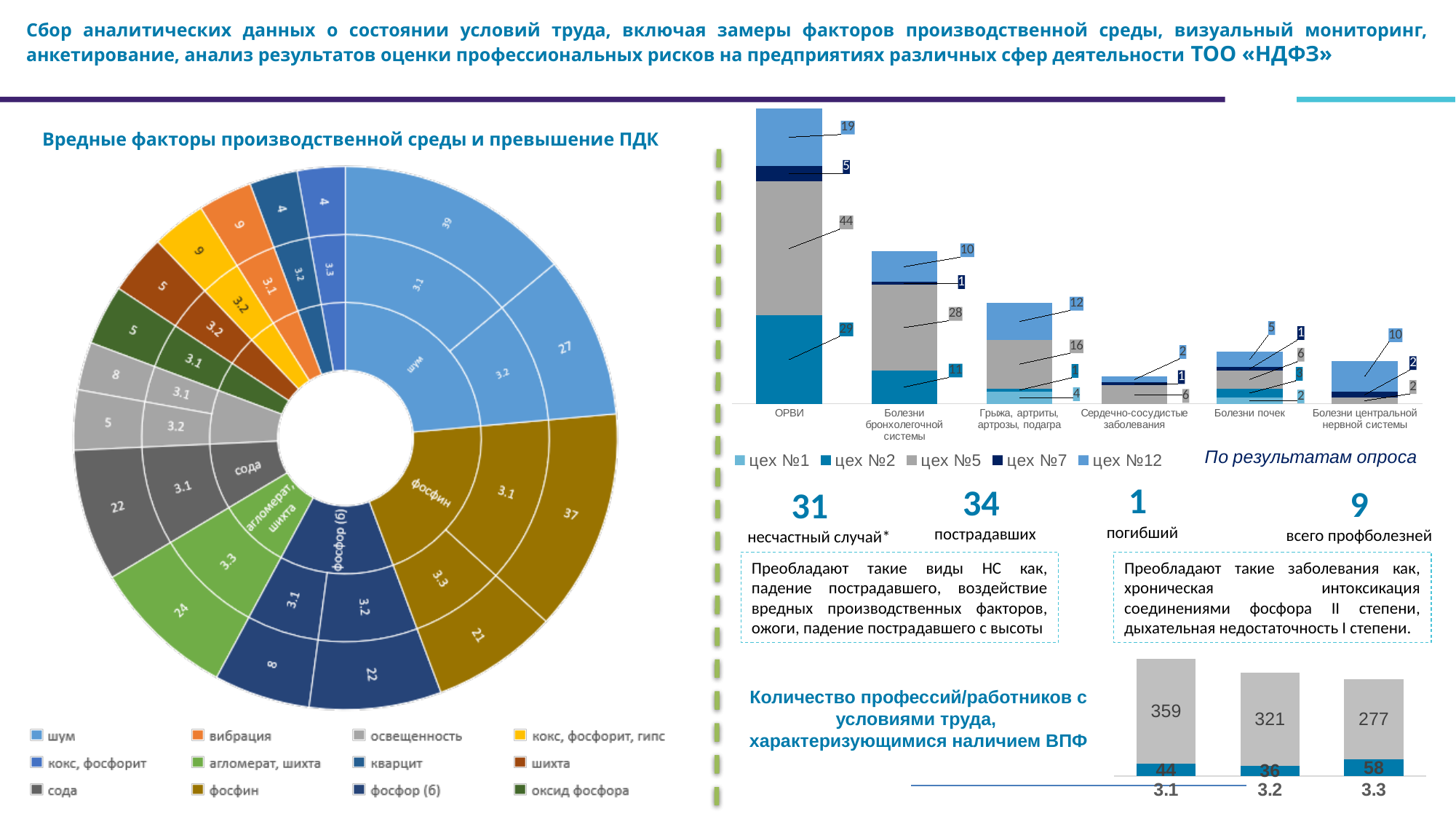
In the top-right chart of diseases by workshop, which disease category has the tallest stacked bar? ОРВИ In the top-right chart of diseases by workshop, what is the value for цех №5 in the ОРВИ category? 44 In the top-right chart of diseases by workshop, what is the total of the stacked bar for ОРВИ? 97 How many entries does the legend of the left chart 'Вредные факторы производственной среды и превышение ПДК' list? 12 In the top-right chart of diseases by workshop, what is the value for цех №2 in the Болезни бронхолегочной системы category? 11 In the bottom-right chart 'Количество профессий/работников с условиями труда, характеризующимися наличием ВПФ', what is the value of the grey segment for category 3.1? 359 In the top-right chart of diseases by workshop, how many disease categories are shown on the x axis? 6 What kind of chart is the top-right chart showing diseases by workshop (цех)? stacked bar chart In the bottom-right chart 'Количество профессий/работников с условиями труда, характеризующимися наличием ВПФ', do the grey segment values rise or fall from 3.1 to 3.3? fall In the top-right chart of diseases by workshop, how many series does the legend list? 5 In the bottom-right chart 'Количество профессий/работников с условиями труда, характеризующимися наличием ВПФ', what is the total of the stacked bar for category 3.3? 335 In the top-right chart of diseases by workshop, what is the difference between the цех №12 values for ОРВИ and Болезни бронхолегочной системы? 9